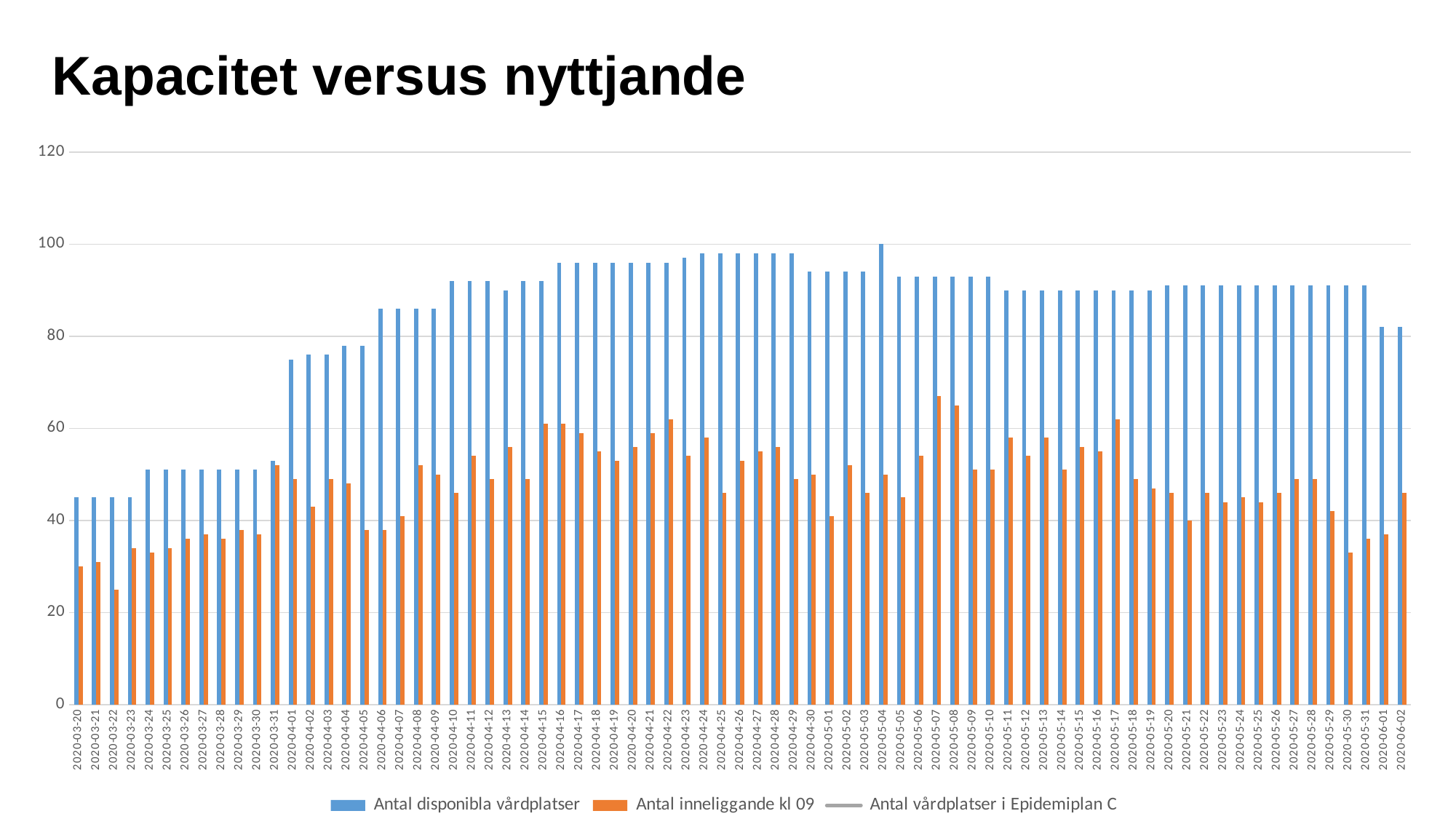
What kind of chart is shown on the slide? bar chart How many series does the legend list? 3 Which series is shown in orange in the legend? Antal inneliggande kl 09 On which date is the value for Antal disponibla vårdplatser highest? 2020-05-04 What is the title of the chart? Kapacitet versus nyttjande Is the value for Antal disponibla vårdplatser on 2020-03-20 greater or less than 40? greater Is the value for Antal inneliggande kl 09 on 2020-05-30 greater or less than 40? less On which date is the value for Antal inneliggande kl 09 lowest? 2020-03-22 Which is larger: Antal inneliggande kl 09 on 2020-05-07 or on 2020-03-22? 2020-05-07 Do the values for Antal disponibla vårdplatser generally rise or fall from 2020-03-20 to 2020-05-04? rise Is the value for Antal inneliggande kl 09 on 2020-05-07 greater or less than 60? greater What is the value for Antal disponibla vårdplatser on 2020-05-04? 100